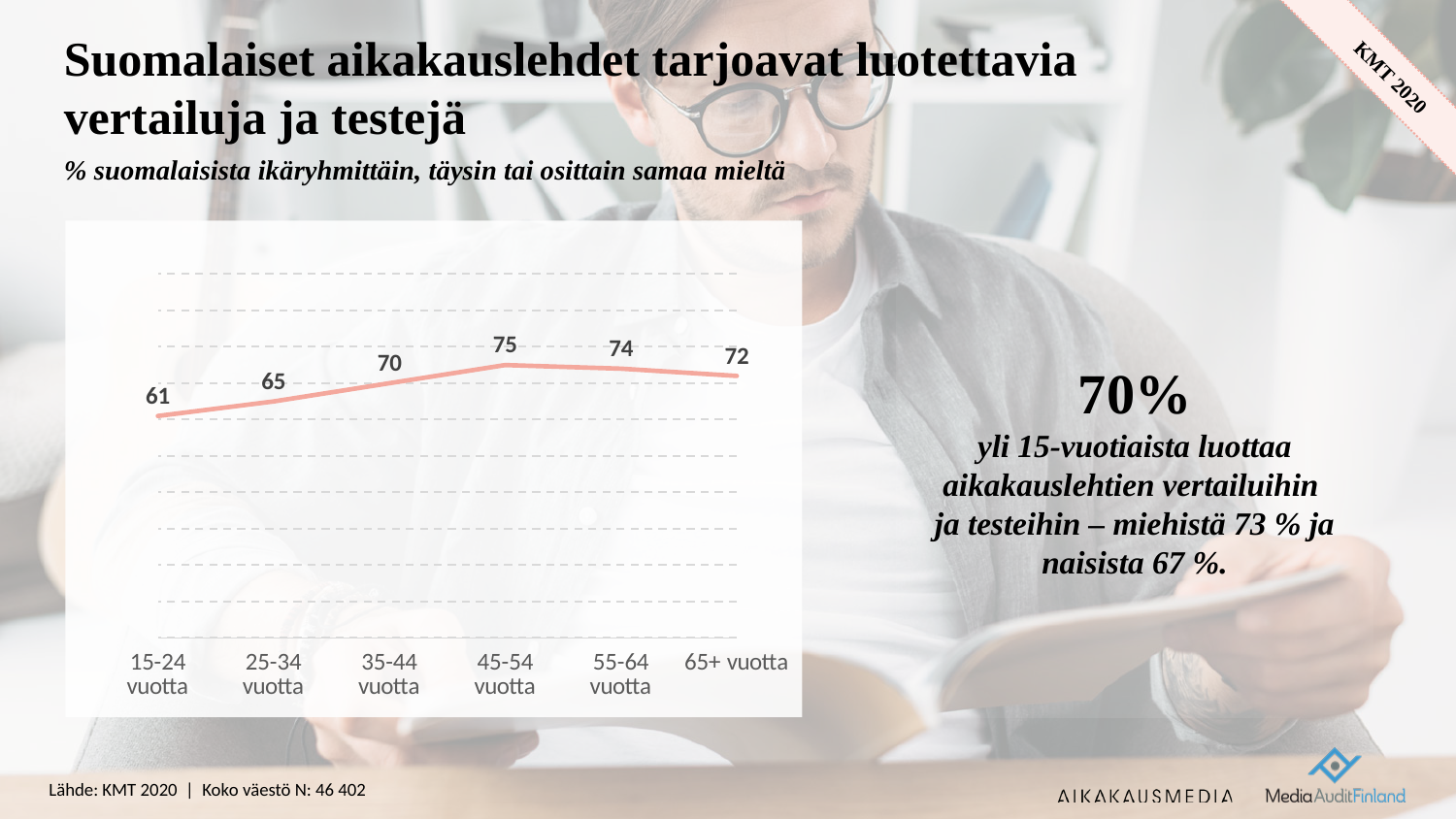
Do the values rise or fall from 15-24 vuotta to 45-54 vuotta? Rise Which age group has the highest value? 45-54 vuotta What is the difference between the values for 35-44 vuotta and 25-34 vuotta? 5 What is the value for the 55-64 vuotta age group? 74 What kind of chart is shown on the slide? Line chart Which age group has the lowest value? 15-24 vuotta What is the value for the 45-54 vuotta age group? 75 Which is larger, the value for 55-64 vuotta or the value for 65+ vuotta? 55-64 vuotta What is the value for the 65+ vuotta age group? 72 How many age groups are plotted on the chart? 6 What is the value for the 15-24 vuotta age group? 61 What is the difference between the values for 45-54 vuotta and 15-24 vuotta? 14